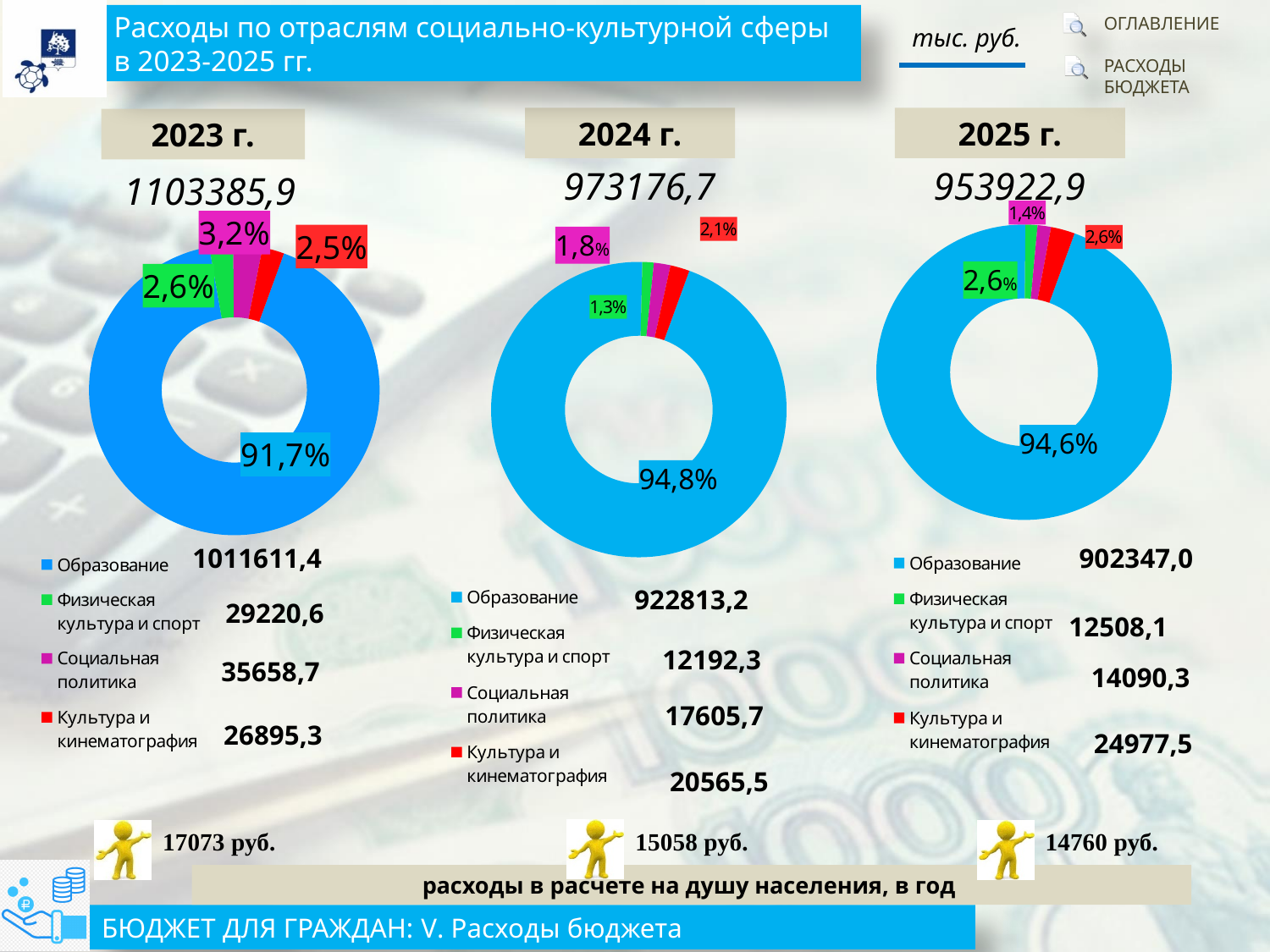
How many categories does the 2024 г. chart show? 4 In the 2024 г. chart, which category has the largest value? Образование In the 2025 г. chart, what share does Социальная политика have? 1,4% In the 2025 г. chart, which category has the smallest value? Физическая культура и спорт In the 2024 г. chart, what share does Физическая культура и спорт have? 1,3% In the 2023 г. chart, what share does Образование have? 91,7% In the 2023 г. chart, what is the difference between Социальная политика and Культура и кинематография? 8763,4 In the 2023 г. chart, which is larger: Физическая культура и спорт or Культура и кинематография? Физическая культура и спорт In the 2023 г. chart, what is the value for Социальная политика? 35658,7 In the 2025 г. chart, what is the value for Образование? 902347,0 In the 2024 г. chart, what is the value for Культура и кинематография? 20565,5 What kind of chart is used for the 2023 г. data? Donut (pie) chart